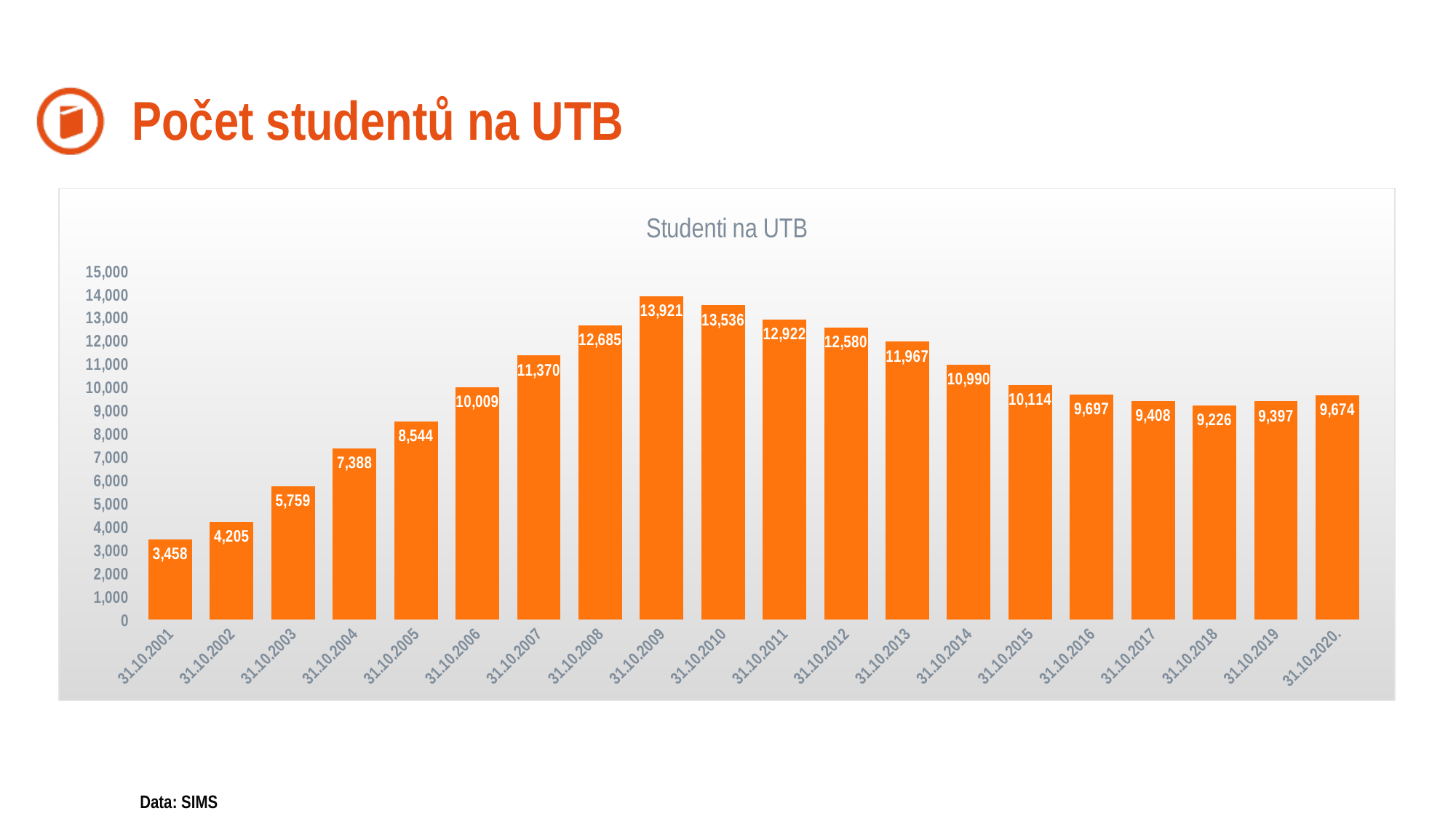
Do the values rise or fall from 31.10.2001 to 31.10.2009? rise What is the value for 31.10.2020? 9,674 What kind of chart is shown on the slide? bar chart Which date has the highest number of students? 31.10.2009 What is the title of the chart? Studenti na UTB How many bars are shown in the chart? 20 Which date has the lowest number of students? 31.10.2001 Is the value for 31.10.2013 greater or less than 11,000? greater Which is larger, the value for 31.10.2016 or the value for 31.10.2019? 31.10.2016 What is the value for 31.10.2009? 13,921 What is the difference between the values for 31.10.2009 and 31.10.2020? 4,247 What is the value for 31.10.2001? 3,458